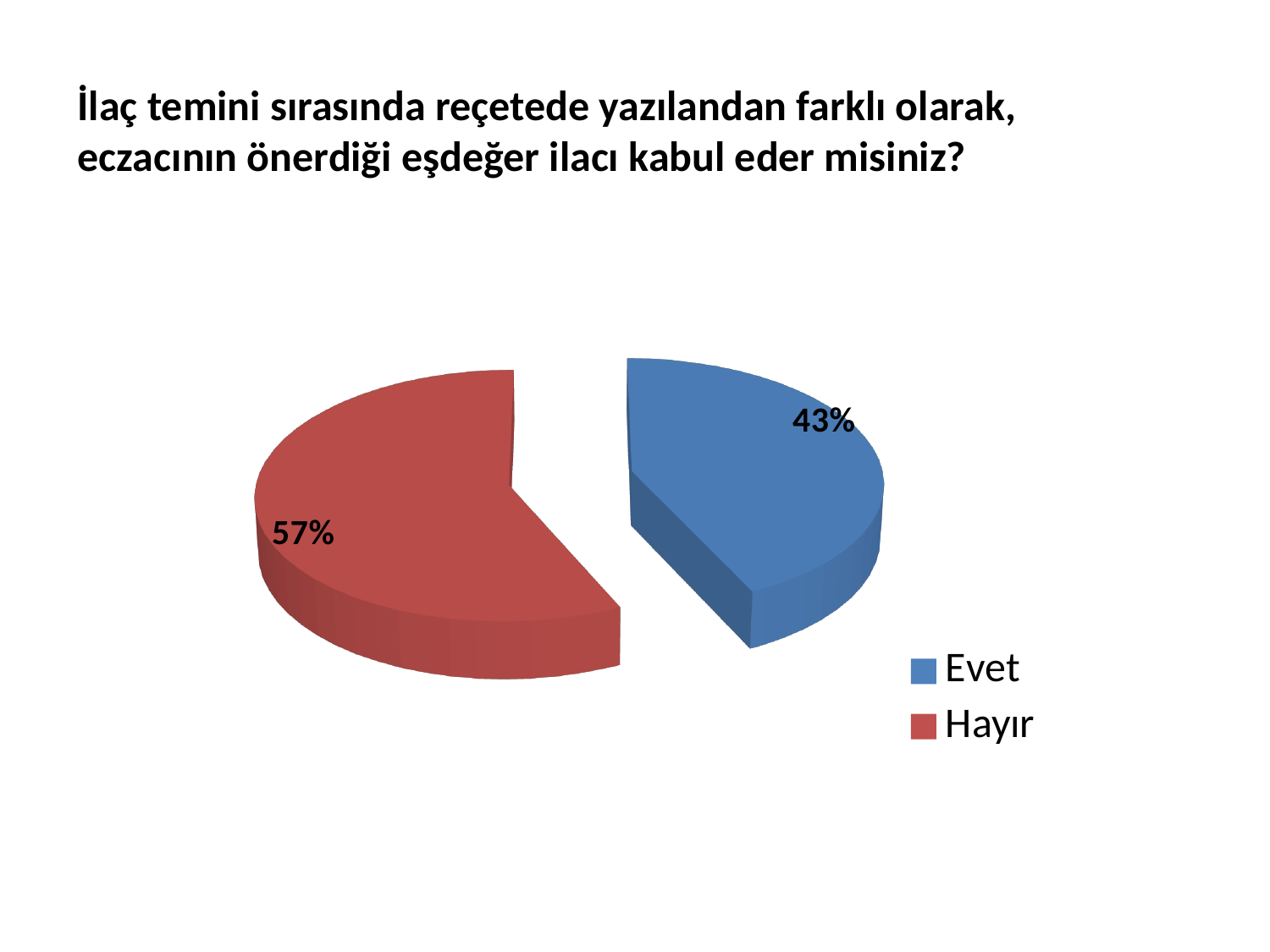
What share of the pie does the Hayır slice represent? 57% What is the difference in percentage points between the Hayır and Evet slices? 14 How many entries does the legend list? 2 Which response has the larger share of the pie? Hayır Is the share for Evet larger or smaller than the share for Hayır? Smaller What colour is the Hayır slice? Red What kind of chart is shown on the slide? Pie chart What colour is the Evet slice? Blue How many slices does the pie chart have? 2 What percentage of respondents answered Evet? 43% Which response has the smaller share of the pie? Evet What percentage of respondents answered Hayır? 57%